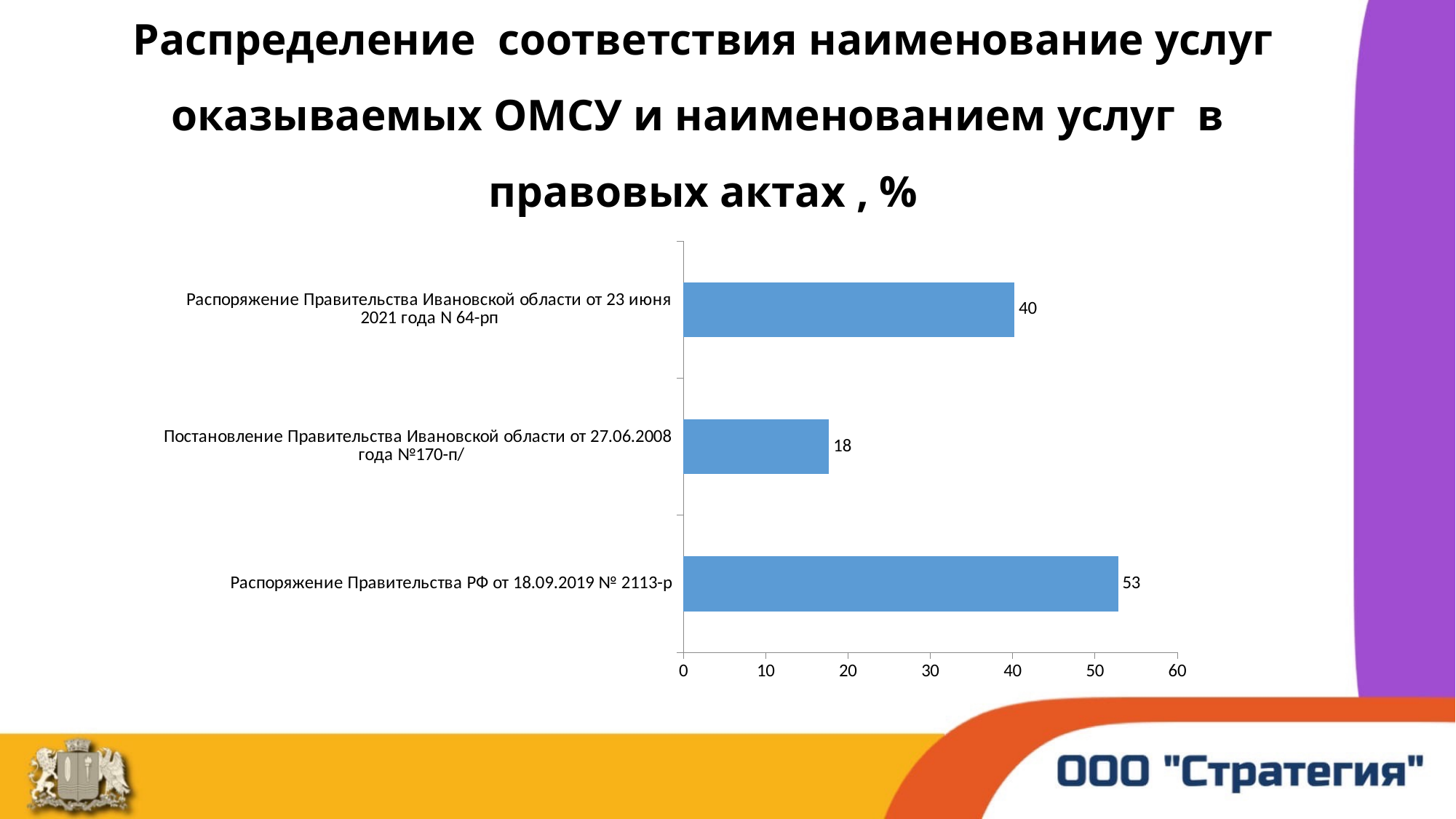
What is the value for Распоряжение Правительства РФ от 18.09.2019 № 2113-р? 53 Which is larger: the value for Распоряжение Правительства Ивановской области от 23 июня 2021 года N 64-рп or the value for Постановление Правительства Ивановской области от 27.06.2008 года №170-п/? Распоряжение Правительства Ивановской области от 23 июня 2021 года N 64-рп What is the maximum value shown on the horizontal axis? 60 How many categories are shown in the chart? 3 Which category has the highest value? Распоряжение Правительства РФ от 18.09.2019 № 2113-р What is the difference between the values for Распоряжение Правительства РФ от 18.09.2019 № 2113-р and Распоряжение Правительства Ивановской области от 23 июня 2021 года N 64-рп? 13 What kind of chart is shown on the slide? bar chart What is the value for Постановление Правительства Ивановской области от 27.06.2008 года №170-п/? 18 Which category has the lowest value? Постановление Правительства Ивановской области от 27.06.2008 года №170-п/ Is the value for Распоряжение Правительства РФ от 18.09.2019 № 2113-р greater or less than 50? greater What is the difference between the values for Распоряжение Правительства Ивановской области от 23 июня 2021 года N 64-рп and Постановление Правительства Ивановской области от 27.06.2008 года №170-п/? 22 What is the value for Распоряжение Правительства Ивановской области от 23 июня 2021 года N 64-рп? 40